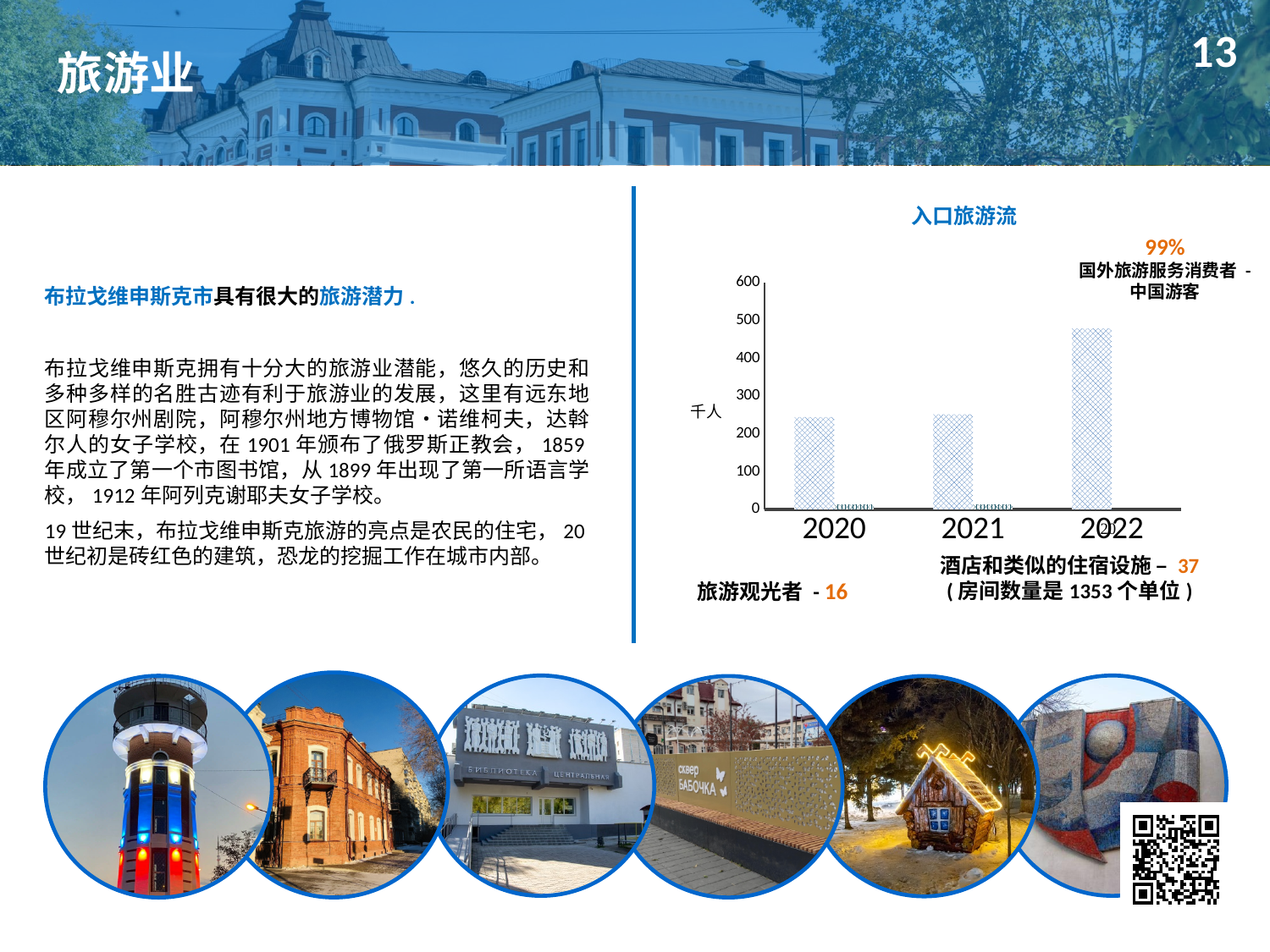
Is the value for 2021 in the 入口旅游流 chart greater or less than 200? greater In the 入口旅游流 chart, which is larger, the value for 2020 or the value for 2022? 2022 Which year has the highest value in the 入口旅游流 chart? 2022 Is the value for 2020 in the 入口旅游流 chart greater or less than 300? less Is the value for 2022 in the 入口旅游流 chart greater or less than 500? less What kind of chart is shown under the title 入口旅游流? bar chart What is the title of the chart on the slide? 入口旅游流 How many years are shown on the x axis of the 入口旅游流 chart? 3 What unit label is shown on the y axis of the 入口旅游流 chart? 千人 What is the highest tick value on the y axis of the 入口旅游流 chart? 600 Do the values in the 入口旅游流 chart rise or fall from 2020 to 2022? rise